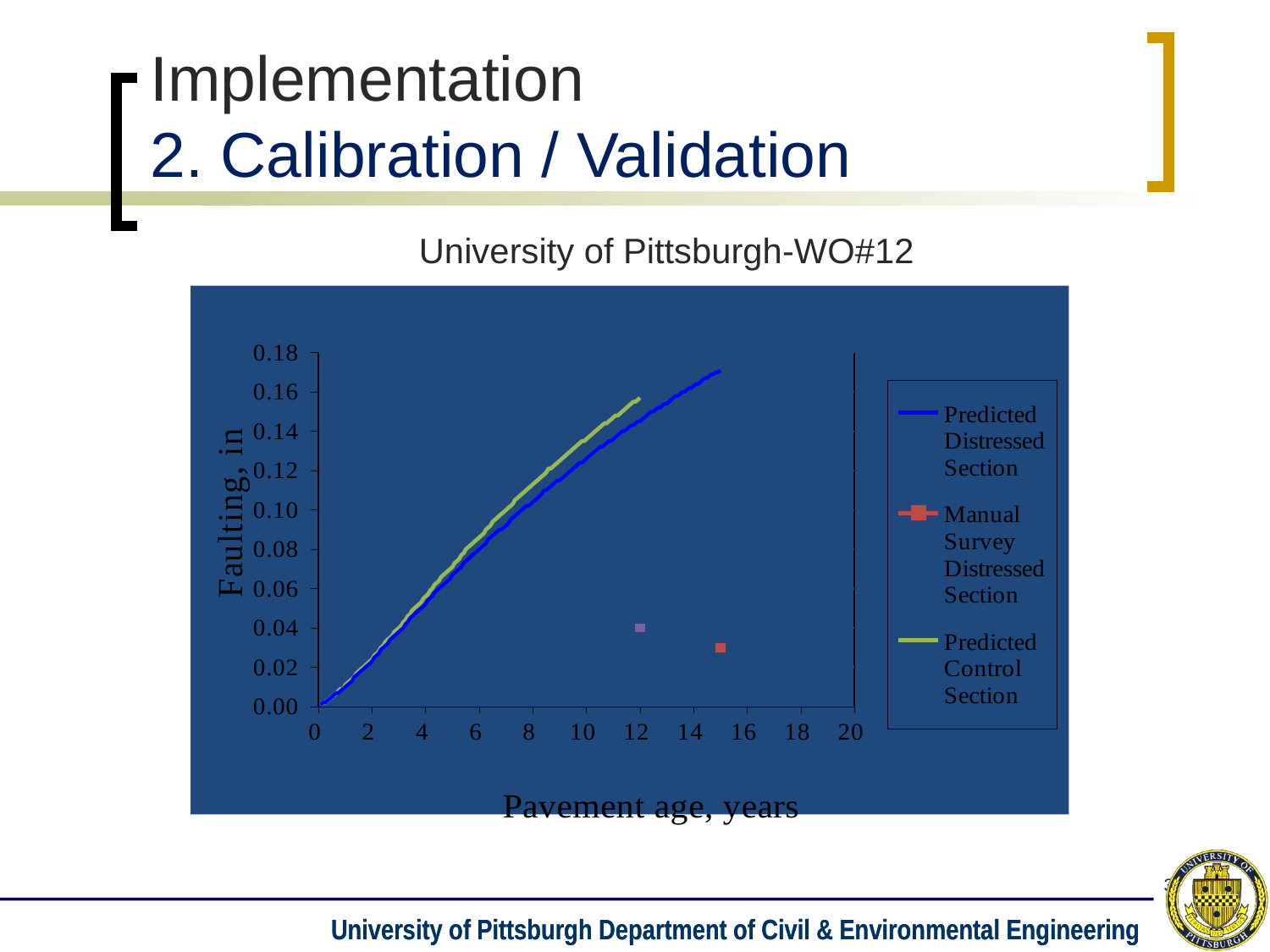
Does the Predicted Control Section line rise or fall as pavement age increases? rise Does the Predicted Distressed Section line rise or fall as pavement age increases? rise Is the Predicted Distressed Section value at a pavement age of 15 years greater or less than 0.16? greater How many series does the legend list? 3 Is the Manual Survey Distressed Section value at a pavement age of 15 years greater or less than 0.04? less What kind of chart is shown on the slide? line chart At a pavement age of 8 years, which is higher: the Predicted Control Section or the Predicted Distressed Section? Predicted Control Section What is the label of the x axis? Pavement age, years Is the Predicted Control Section value at a pavement age of 12 years greater or less than 0.14? greater What is the title of the chart? University of Pittsburgh-WO#12 Which series reaches the highest faulting value on the chart? Predicted Distressed Section